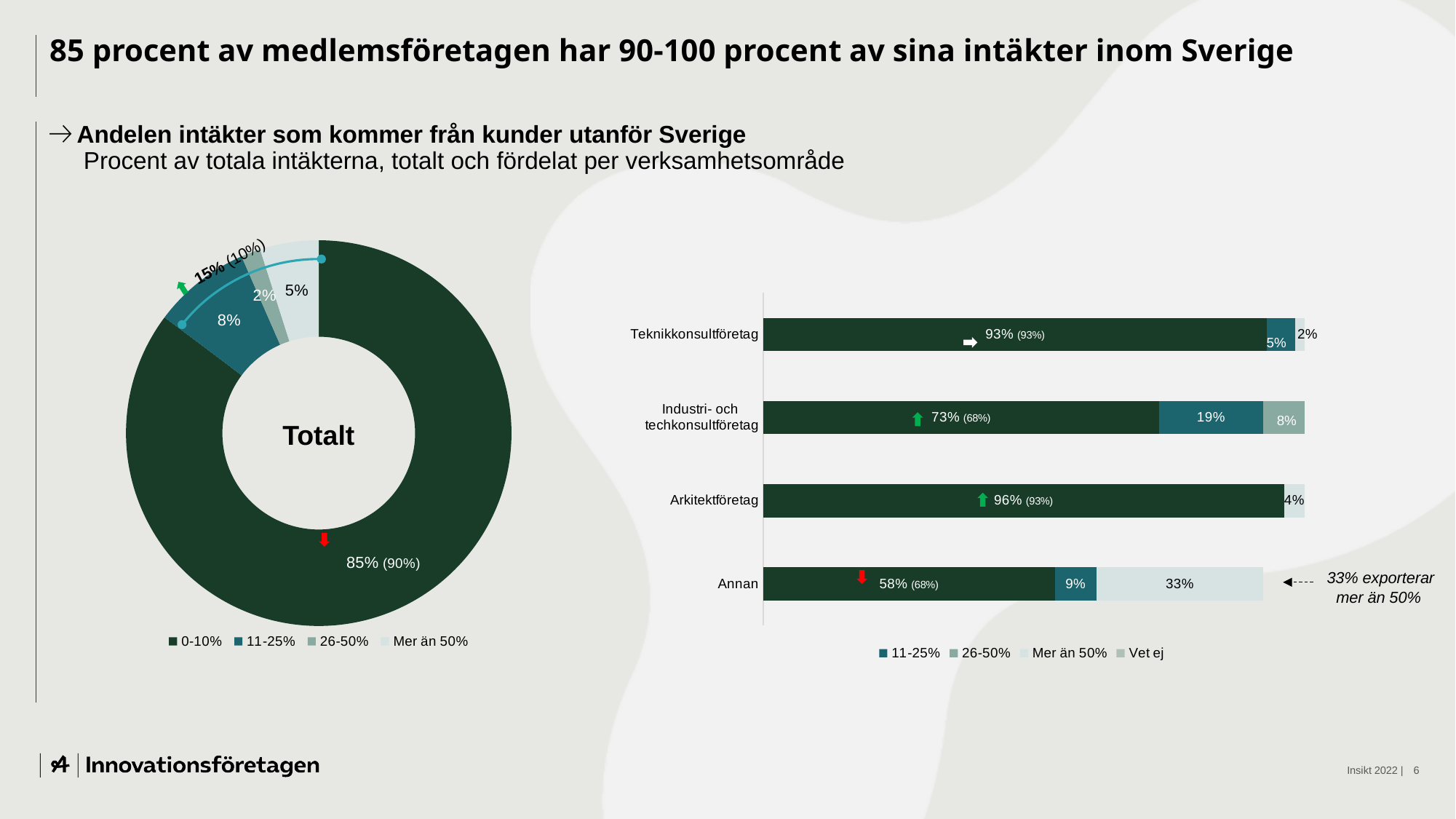
In the bar chart on the right, what is the difference between the first-segment values for Industri- och techkonsultföretag (73%) and Annan (58%)? 15 percentage points In the donut chart on the left, what is the value shown for the 'Mer än 50%' slice? 5% In the donut chart on the left, what is the value shown for the 11-25% slice? 8% In the bar chart on the right, what is the value of the first (dark green) segment for Arkitektföretag? 96% In the bar chart on the right, what is the 11-25% value for Industri- och techkonsultföretag? 19% What type of chart is shown on the right side of the slide? Stacked horizontal bar chart In the donut chart on the left, what share of companies have 0-10% of their revenue from customers outside Sweden? 85% How many categories are shown in the bar chart on the right? 4 In the donut chart on the left, what value is shown in parentheses next to the 85% label? 90% In the bar chart on the right, which category has the highest value in its first (dark green) segment? Arkitektföretag In the donut chart on the left, which category has the smallest slice? 26-50% In the bar chart on the right, what is the 'Mer än 50%' value for Annan? 33%